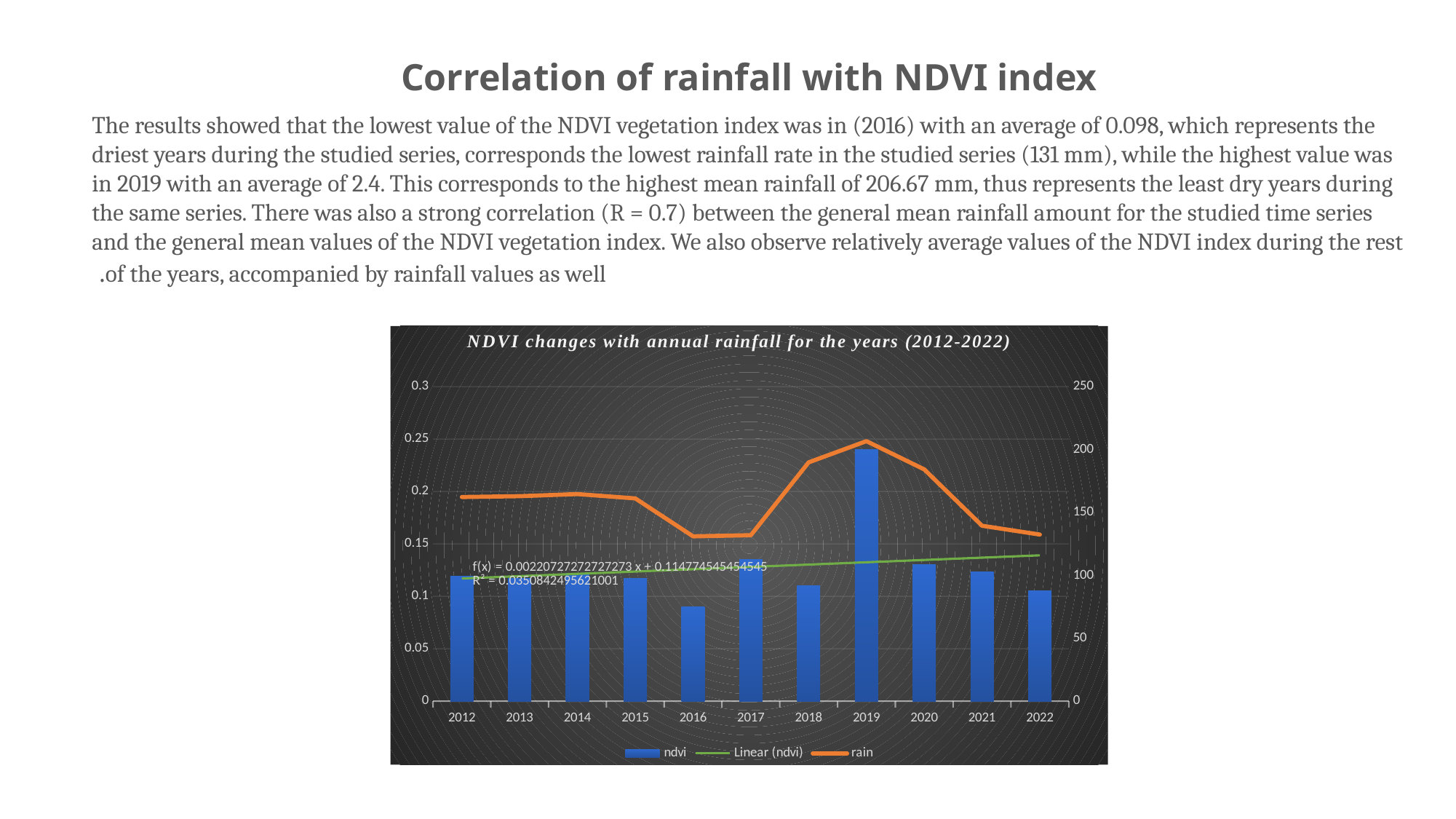
Which year has the larger ndvi bar, 2017 or 2018? 2017 Which year has the highest ndvi bar? 2019 Is the ndvi value for 2016 greater or less than 0.1? less What is the title of the chart? NDVI changes with annual rainfall for the years (2012-2022) How many years are shown on the x axis of the chart? 11 How many entries does the chart legend list? 3 What kind of chart is shown on the slide? Combination bar and line chart Is the rain value for 2019 greater or less than 200? greater Does the rain line rise or fall from 2019 to 2022? fall In which year does the rain line reach its highest point? 2019 Is the ndvi value for 2019 greater or less than 0.2? greater Which year has the lowest ndvi bar? 2016